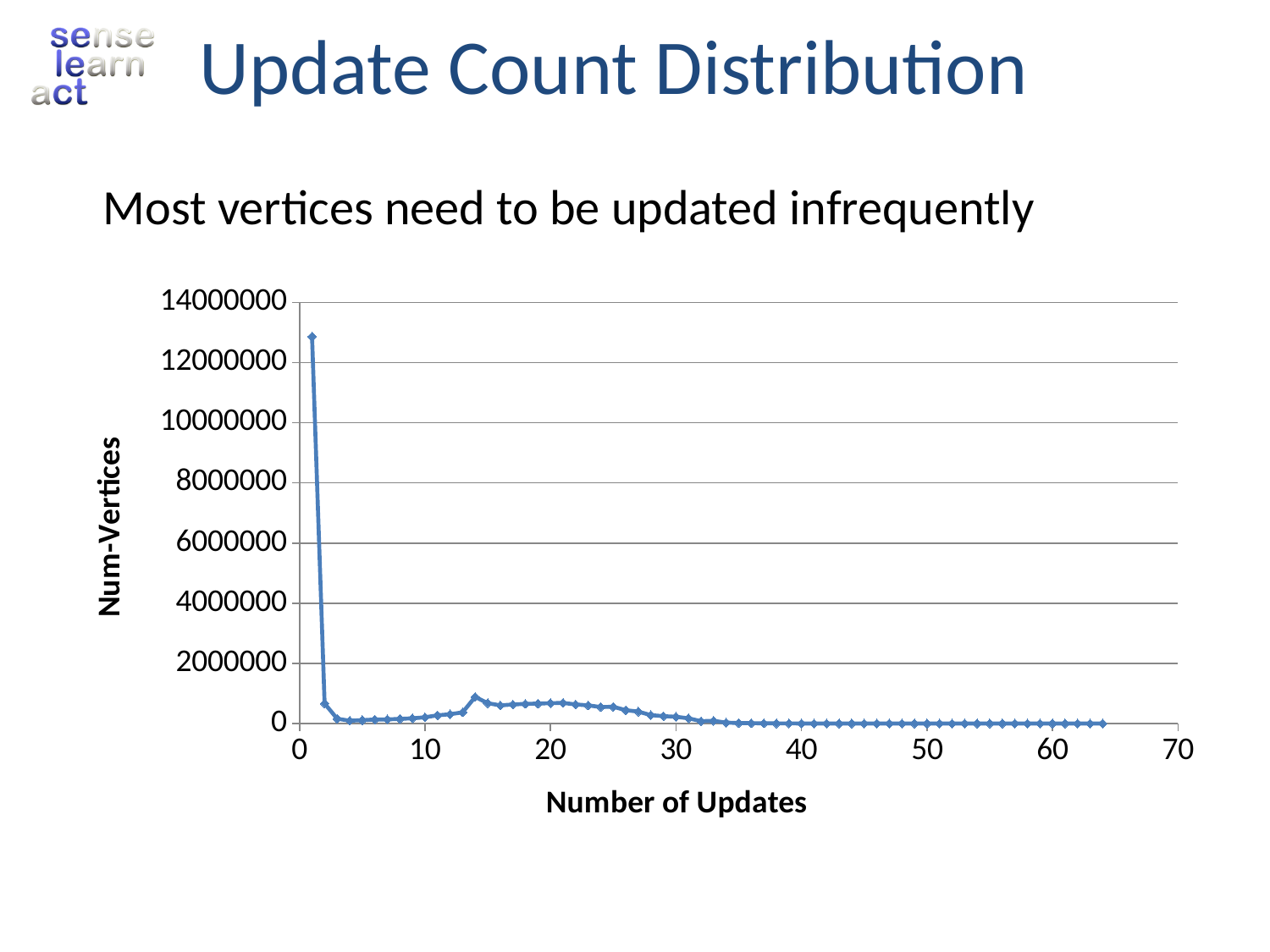
Which has more vertices: 1 update or 2 updates? 1 update What is the title of the y axis of the chart? Num-Vertices What is the title of the x axis of the chart? Number of Updates Which has more vertices: 14 updates or 50 updates? 14 updates Is the number of vertices at 20 updates greater or less than 2000000? less At which number of updates is the number of vertices highest? 1 Is the number of vertices at 2 updates greater or less than 2000000? less What kind of chart is shown on the slide? line chart Is the number of vertices at 1 update greater or less than 14000000? less Overall, do the number of vertices rise or fall as the number of updates increases along the x axis? fall